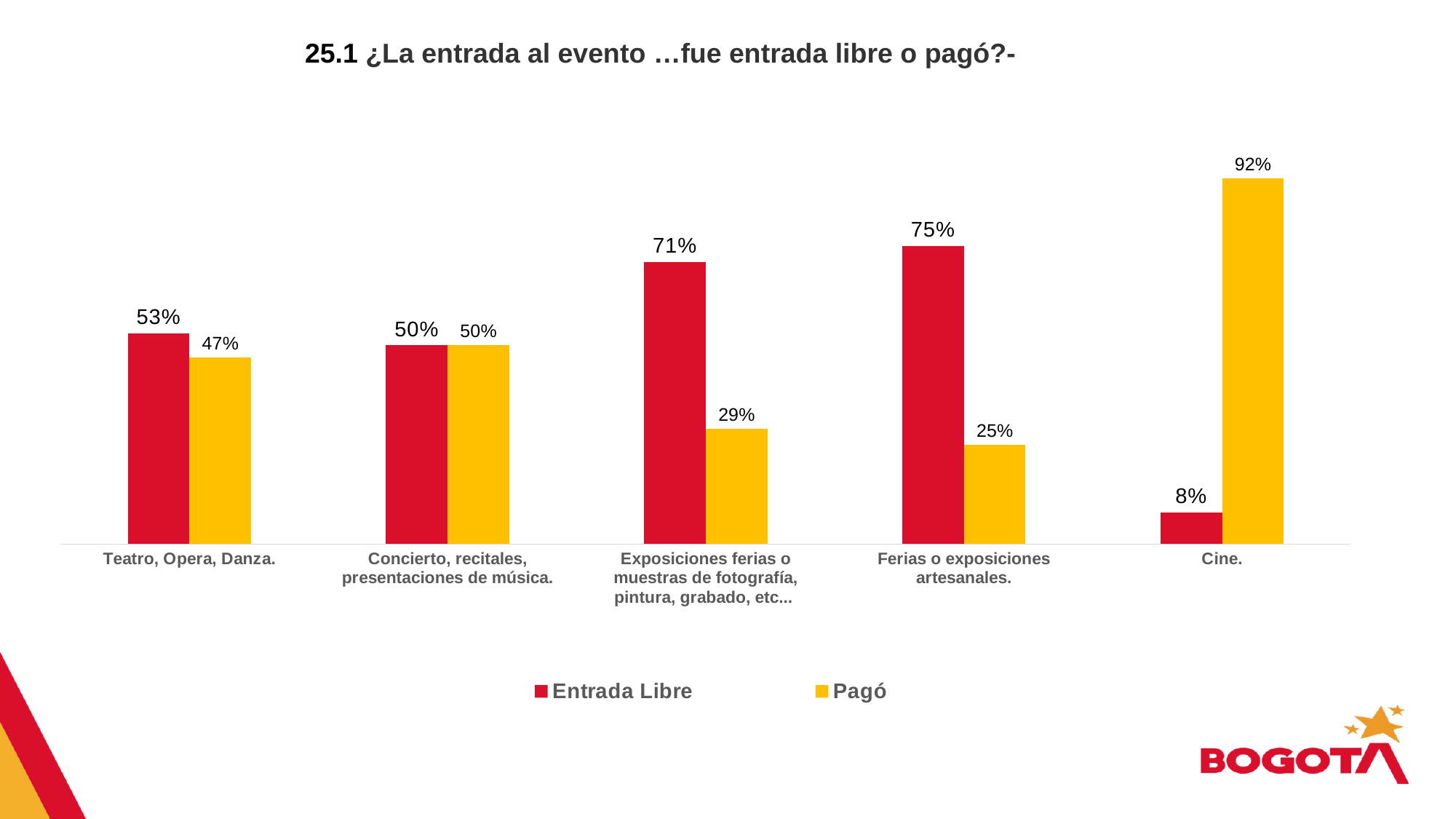
How many categories are shown on the x axis? 5 What is the title of the chart? 25.1 ¿La entrada al evento …fue entrada libre o pagó?- Which category has the lowest Entrada Libre value? Cine. What is the difference between the Entrada Libre and Pagó values for Teatro, Opera, Danza.? 6% What is the Entrada Libre value for Cine.? 8% What is the Pagó value for Exposiciones ferias o muestras de fotografía, pintura, grabado, etc...? 29% How many series does the legend list? 2 What is the Entrada Libre value for Ferias o exposiciones artesanales.? 75% Which is larger for Ferias o exposiciones artesanales., Entrada Libre or Pagó? Entrada Libre Which colour represents the Pagó series? Yellow What kind of chart is shown on the slide? Bar chart Which category has the highest Pagó value? Cine.